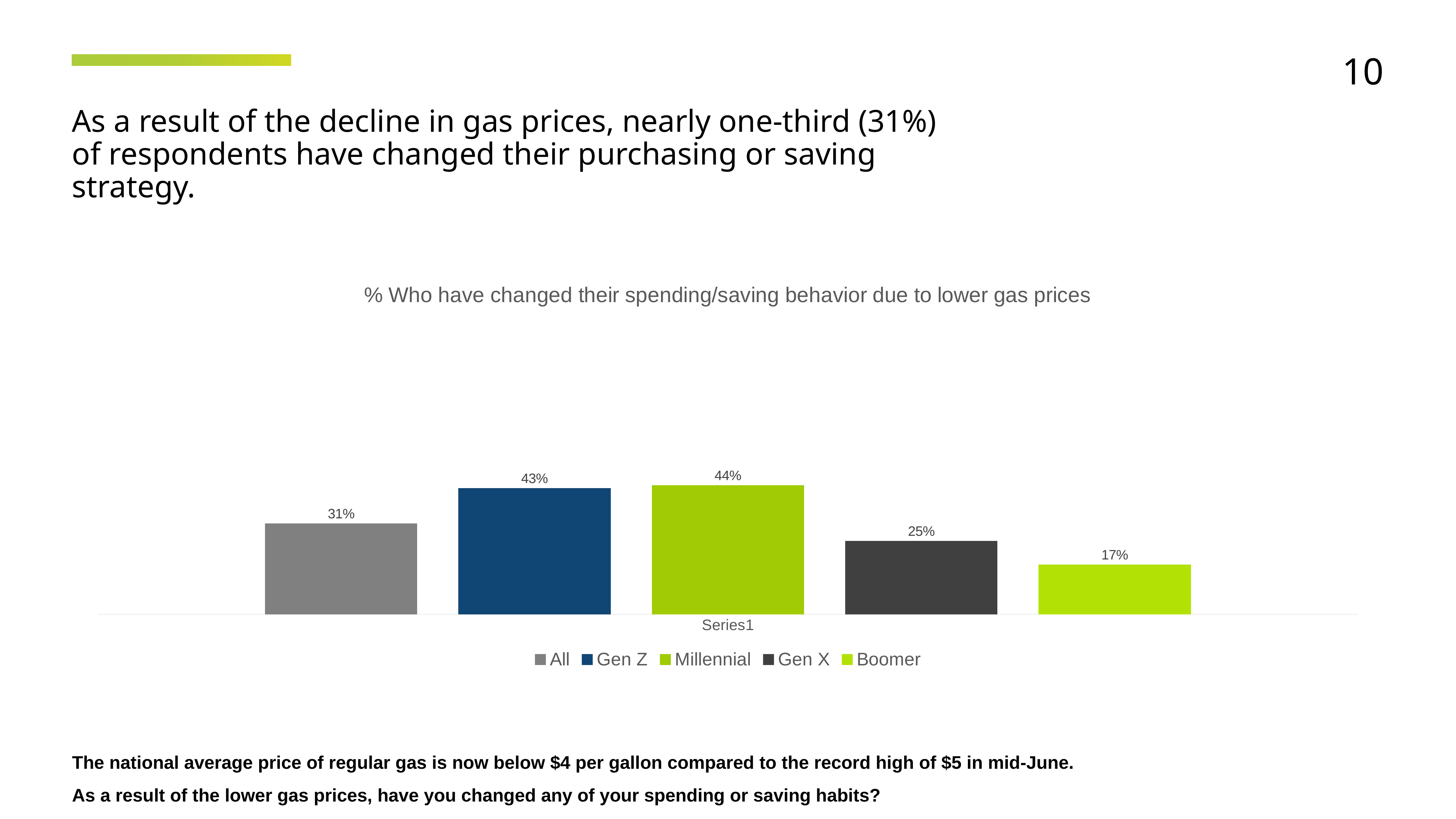
What is the value shown for Boomer? 17% What is the difference between the Gen Z value and the Gen X value? 18% What is the value shown for Gen X? 25% Which is larger, the value for Gen X or the value for Boomer? Gen X Which group has the lowest percentage who changed their spending/saving behavior? Boomer What percentage of all respondents have changed their spending/saving behavior due to lower gas prices? 31% What is the difference between the Millennial value and the Boomer value? 27% What is the title of the chart? % Who have changed their spending/saving behavior due to lower gas prices How many series does the legend list? 5 Which group has the highest percentage who changed their spending/saving behavior? Millennial What kind of chart is shown on the slide? Bar chart What is the value shown for Gen Z? 43%